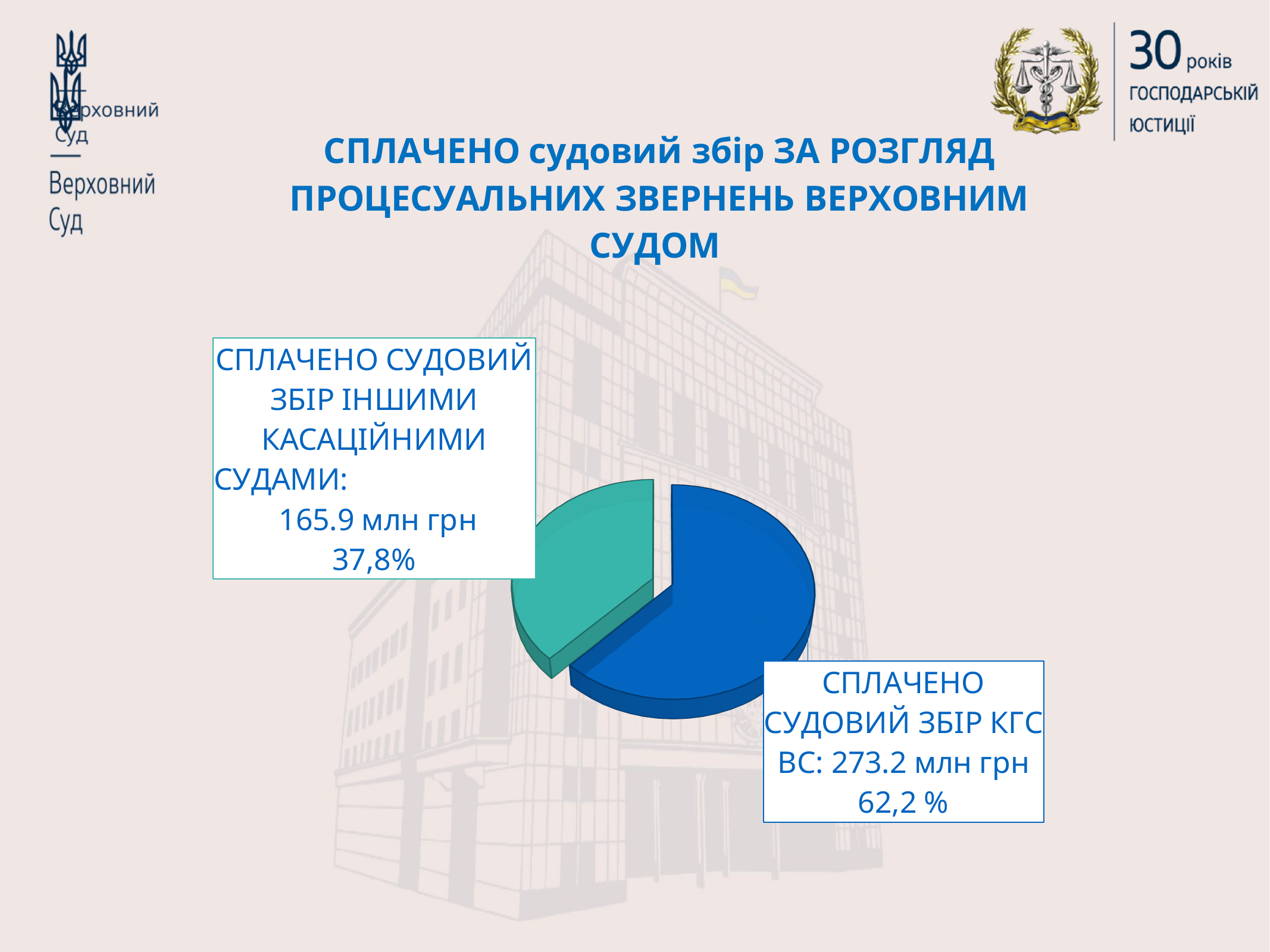
Which slice of the pie chart is the largest? СПЛАЧЕНО СУДОВИЙ ЗБІР КГС ВС What amount of court fee was paid for cases of КГС ВС? 273.2 млн грн What amount of court fee was paid for cases of the other cassation courts (іншими касаційними судами)? 165.9 млн грн How many slices does the pie chart have? 2 What share of the pie does the КГС ВС slice represent? 62,2 % What is the difference between the court fee paid for КГС ВС and for the other cassation courts? 107.3 млн грн What colour is the slice representing КГС ВС? blue What is the total court fee paid across both slices of the pie chart? 439.1 млн грн Which slice of the pie chart is the smallest? СПЛАЧЕНО СУДОВИЙ ЗБІР ІНШИМИ КАСАЦІЙНИМИ СУДАМИ What kind of chart is shown on the slide? pie chart What share of the pie does the slice for the other cassation courts represent? 37,8% Which is larger: the court fee paid for КГС ВС or for the other cassation courts? КГС ВС